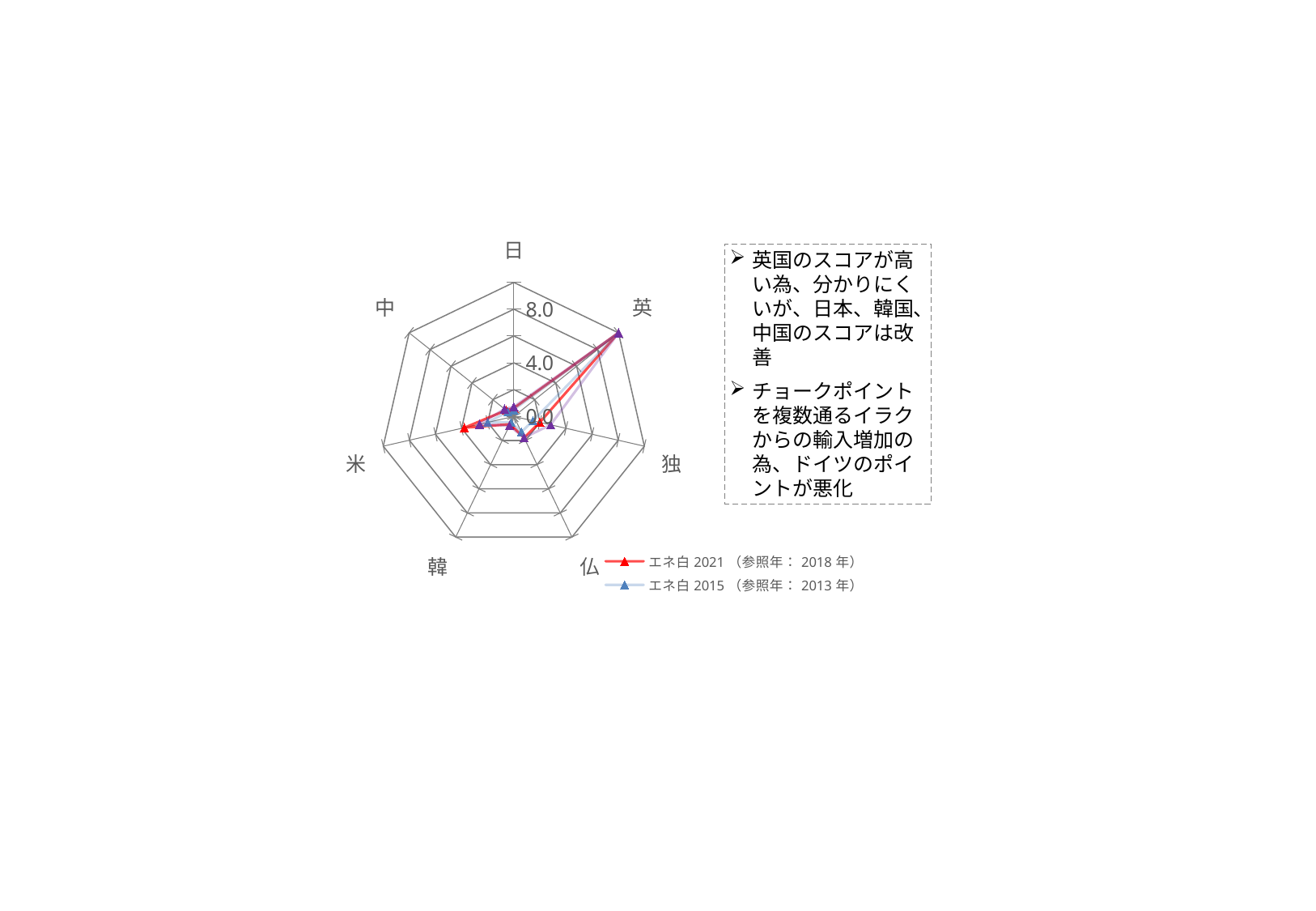
What kind of chart is shown on the slide? Radar chart How many series does the legend list? 2 Which category has the highest value on the radar chart? 英 Is the value for 日 in the エネ白 2021 series greater or less than 4.0? less Which is larger in the エネ白 2015 series, the value for 英 or the value for 日? 英 What is the highest tick label shown on the radar chart's axis? 8.0 Which is larger in the エネ白 2021 series, the value for 英 or the value for 米? 英 Is the value for 英 in the エネ白 2021 series greater or less than 8.0? greater What is the name of the series drawn in red? エネ白 2021 （参照年： 2018 年） How many categories (countries) are plotted on the radar chart? 7